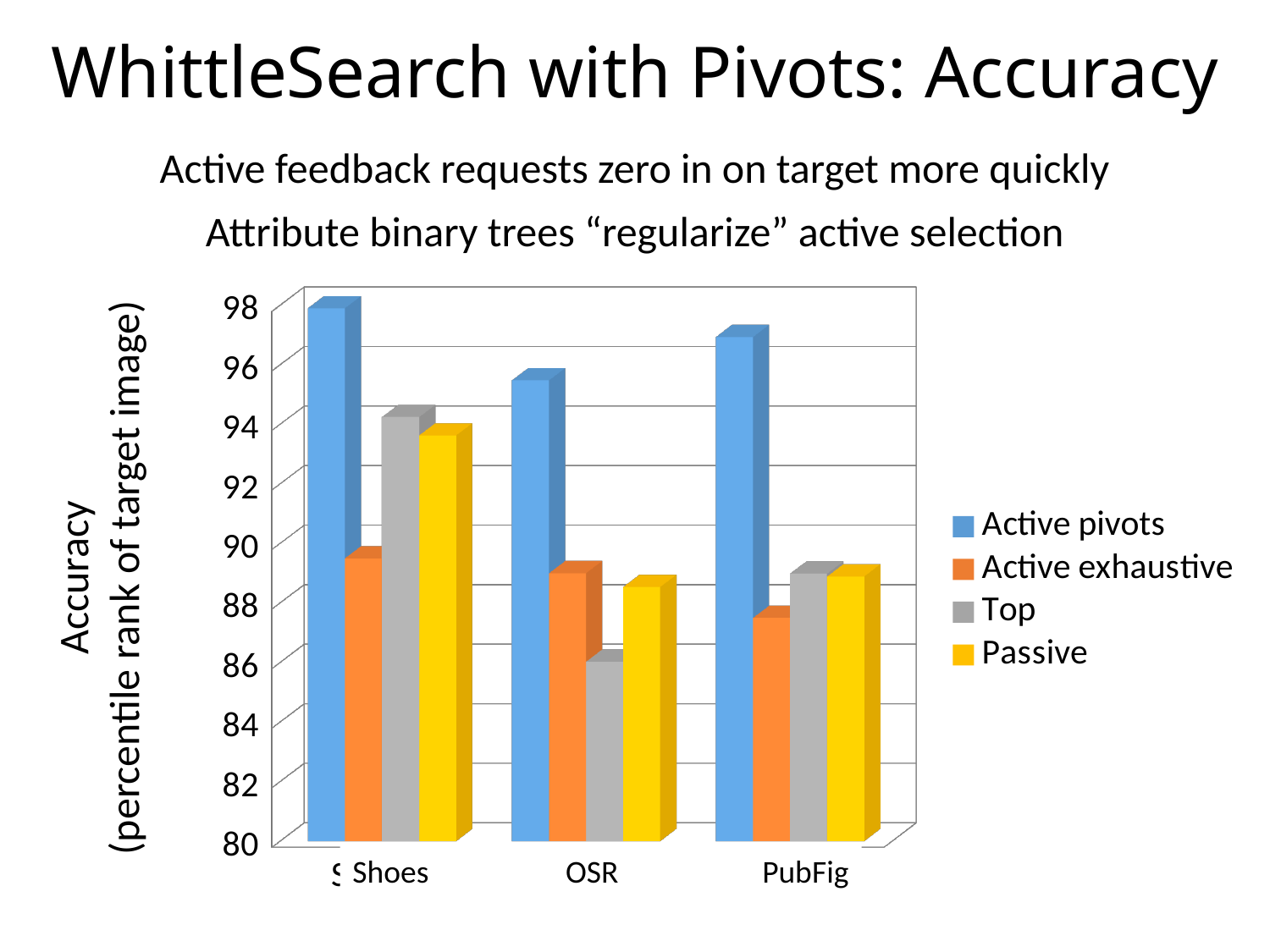
Which series has the lowest value for Shoes? Active exhaustive What kind of chart is shown on the slide? bar chart Which series has the highest value for PubFig? Active pivots Is the Active exhaustive value for PubFig greater or less than 88? less For PubFig, which is larger: Active pivots or Active exhaustive? Active pivots How many categories are shown on the x axis of the chart? 3 What is the label on the chart's vertical axis? Accuracy (percentile rank of target image) How many series does the chart's legend list? 4 Which category has the highest Active pivots value? Shoes Which series has the lowest value for OSR? Top Is the Active pivots value for Shoes greater or less than 96? greater Is the Top value for OSR greater or less than 88? less